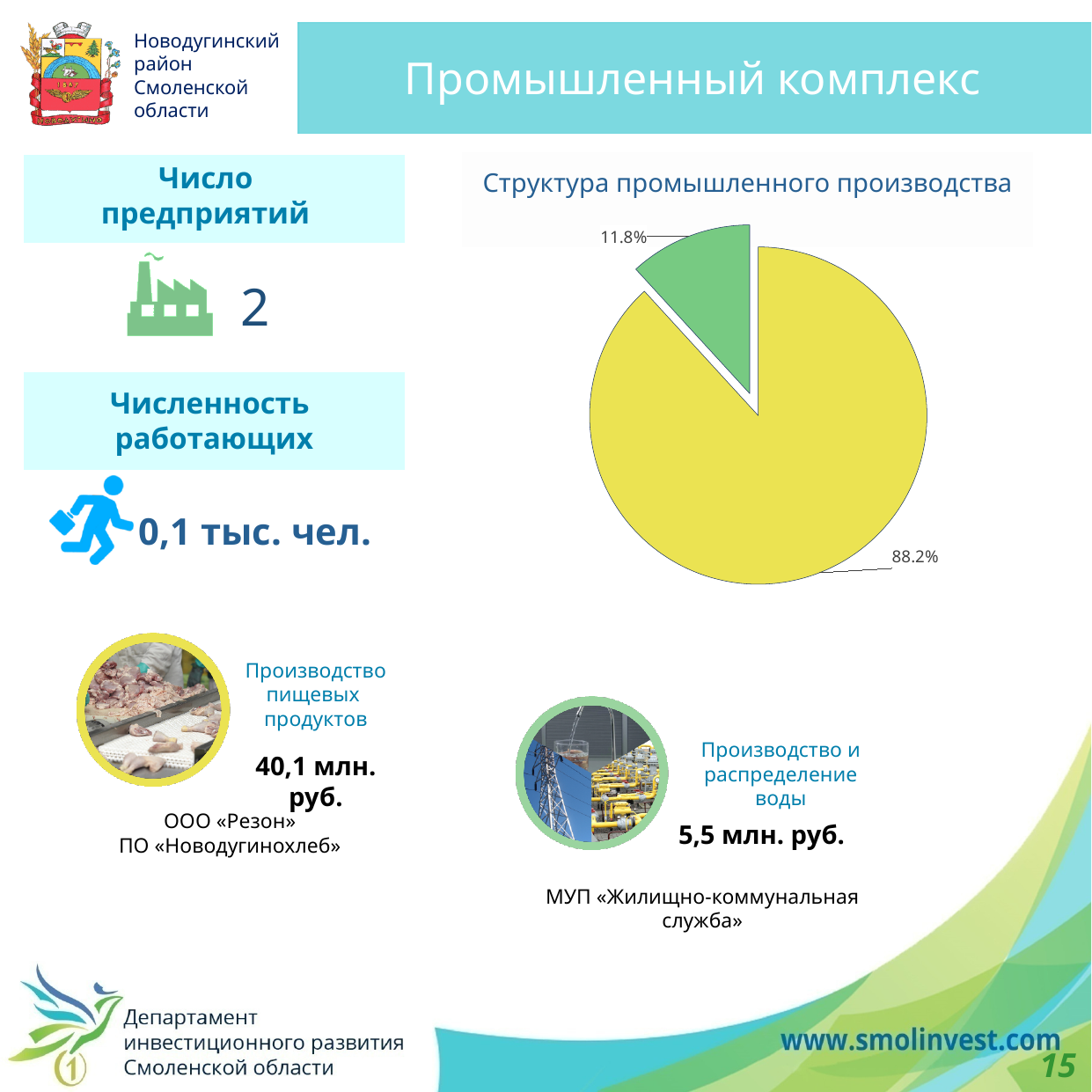
Is the value of the green slice in the pie chart greater or less than 50%? less Which slice of the pie chart is the largest? the yellow slice (88.2%) What is the difference in percentage points between the yellow slice and the green slice of the pie chart? 76.4 How many slices does the pie chart have? 2 What percentage is shown for the yellow slice of the pie chart? 88.2% Which slice of the pie chart is the smallest? the green slice (11.8%) What percentage is shown for the green slice of the pie chart? 11.8% What colour is the slice labelled 88.2% in the pie chart? yellow What is the title of the pie chart on the slide? Структура промышленного производства Which is larger in the pie chart: the yellow slice or the green slice? the yellow slice What share of the pie does the green slice represent? 11.8% What kind of chart is shown under the title "Структура промышленного производства"? pie chart